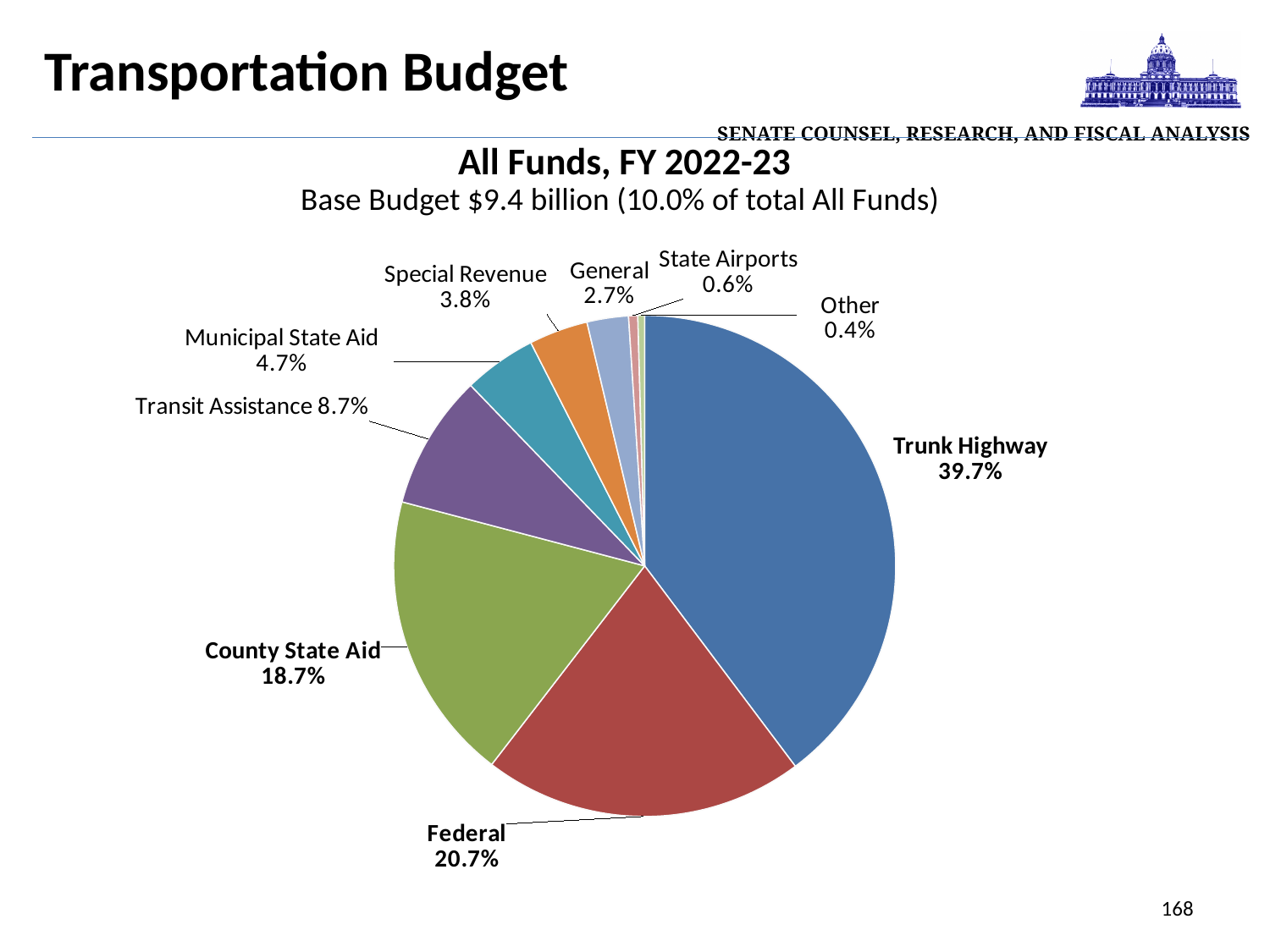
What is the value shown for County State Aid? 18.7% Which category has the largest slice of the pie? Trunk Highway How many categories are shown in the pie chart? 9 Which category has the smallest slice of the pie? Other What is the value shown for Federal? 20.7% What kind of chart is shown on the slide? Pie chart What is the difference between the Federal and County State Aid shares? 2.0% What share of the pie does Trunk Highway represent? 39.7% What is the value shown for Municipal State Aid? 4.7% What is the value shown for Transit Assistance? 8.7% Which is larger, Special Revenue or General? Special Revenue What is the title of the chart? All Funds, FY 2022-23